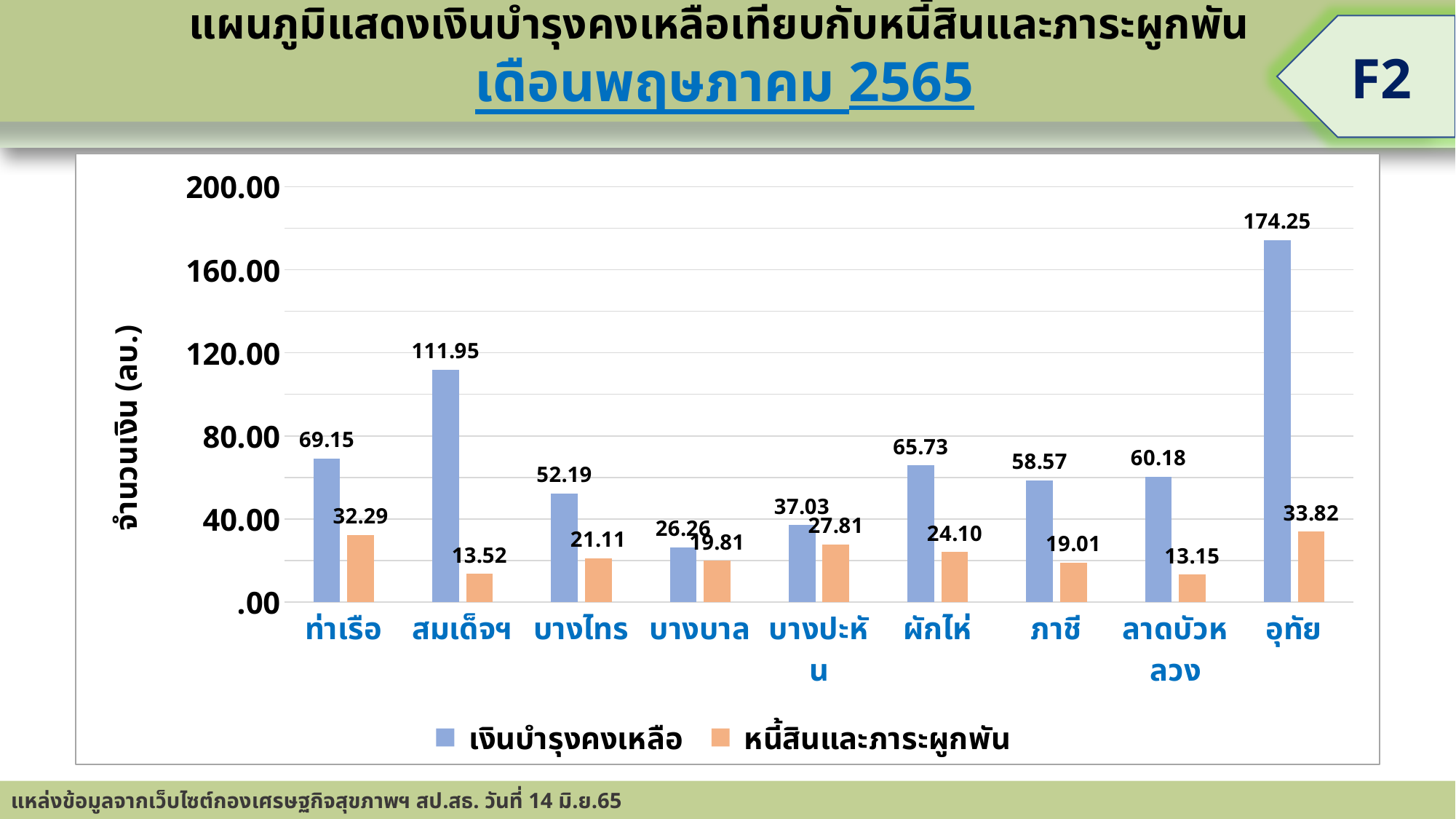
Is the เงินบำรุงคงเหลือ value for สมเด็จฯ greater or less than 80.00? greater How many categories are shown on the x axis? 9 Which category has the highest เงินบำรุงคงเหลือ value? อุทัย What is the เงินบำรุงคงเหลือ value for อุทัย? 174.25 What kind of chart is shown on the slide? bar chart What is the เงินบำรุงคงเหลือ value for บางปะหัน? 37.03 Which category has the lowest เงินบำรุงคงเหลือ value? บางบาล How many series does the legend list? 2 Which is larger: the เงินบำรุงคงเหลือ value for ภาชี or for ลาดบัวหลวง? ลาดบัวหลวง Which category has the lowest หนี้สินและภาระผูกพัน value? ลาดบัวหลวง What is the difference between the เงินบำรุงคงเหลือ and หนี้สินและภาระผูกพัน values for ท่าเรือ? 36.86 What is the หนี้สินและภาระผูกพัน value for สมเด็จฯ? 13.52